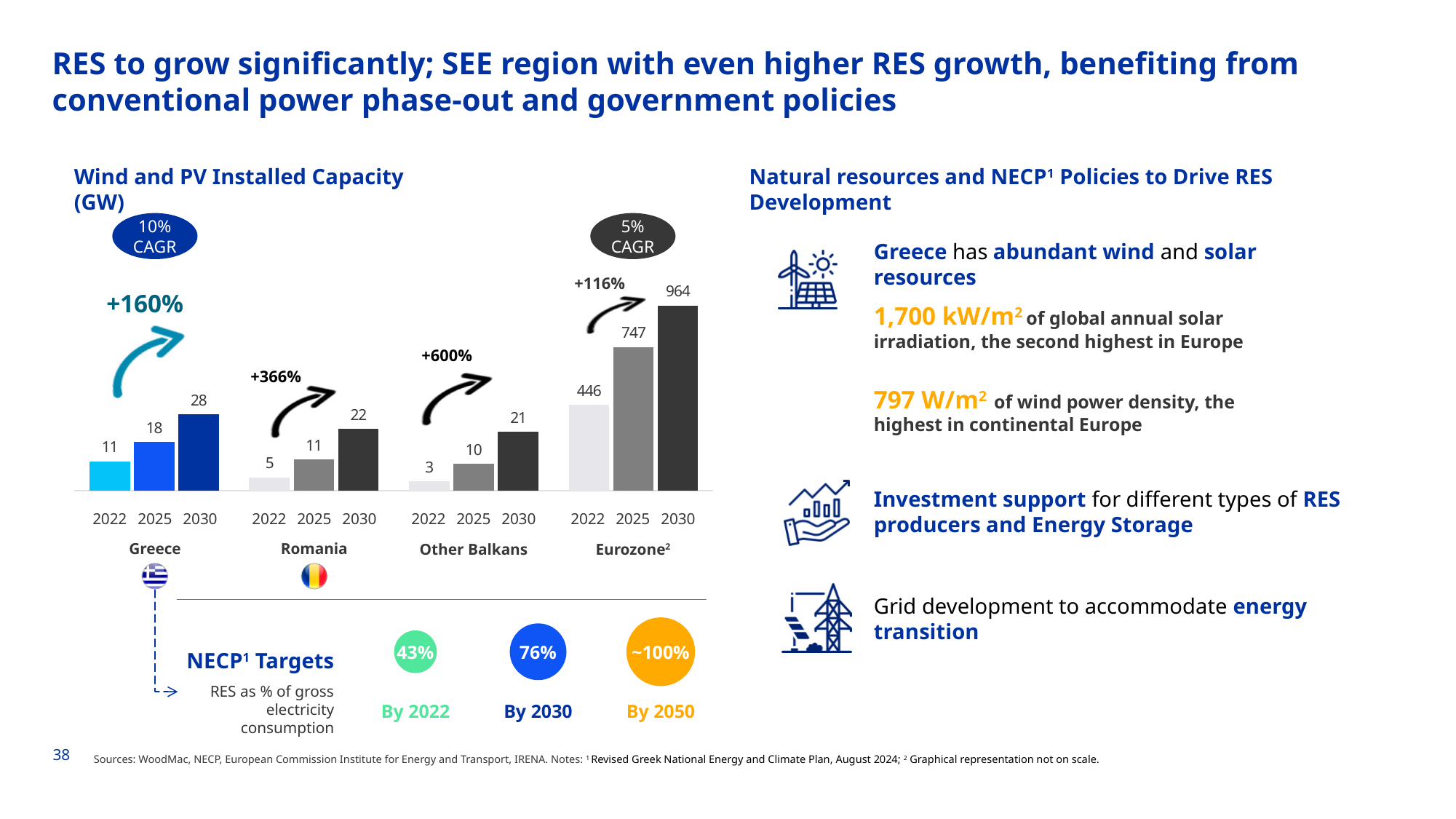
Do the Wind and PV installed capacity values for Romania rise or fall from 2022 to 2030? rise What percentage growth is labelled above the Other Balkans bars? +600% What is the Wind and PV installed capacity for Greece in 2030? 28 How many regions are shown in the Wind and PV Installed Capacity chart? 4 What is the Wind and PV installed capacity for the Eurozone in 2025? 747 What type of chart is the Wind and PV Installed Capacity chart? bar chart By how much does Greece's Wind and PV installed capacity increase from 2022 to 2030? 17 Which is larger: Romania's 2030 capacity or Other Balkans' 2030 capacity? Romania Which region has the highest Wind and PV installed capacity in 2030? Eurozone What is the Wind and PV installed capacity for Romania in 2022? 5 Which region has the lowest Wind and PV installed capacity in 2022? Other Balkans What is the Wind and PV installed capacity for Other Balkans in 2030? 21